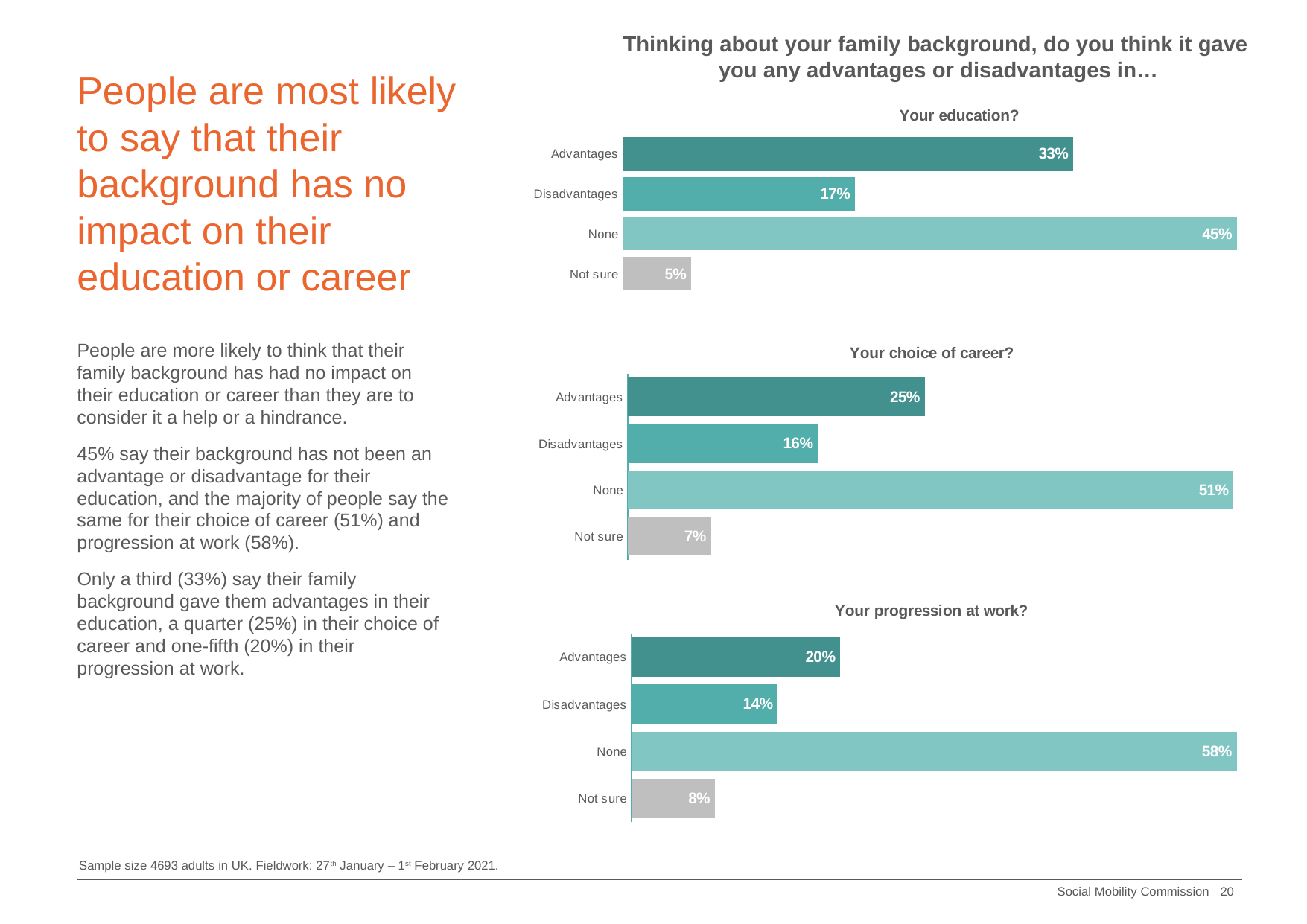
In the 'Your progression at work?' chart, what is the value for Not sure? 8% What is the title of the bottom chart on the slide? Your progression at work? In the 'Your choice of career?' chart, what is the value for Disadvantages? 16% In the 'Your progression at work?' chart, which is larger, Advantages or Disadvantages? Advantages In the 'Your education?' chart, what percentage say their family background gave them advantages? 33% In the 'Your choice of career?' chart, what is the difference between Advantages and Disadvantages? 9 percentage points In the 'Your education?' chart, what is the difference between the None and Advantages values? 12 percentage points How many categories are shown in the 'Your choice of career?' chart? 4 In the 'Your education?' chart, which category has the lowest value? Not sure What type of chart is used for 'Your education?'? Bar chart How many charts are shown on the slide? 3 In the 'Your progression at work?' chart, which category has the highest value? None